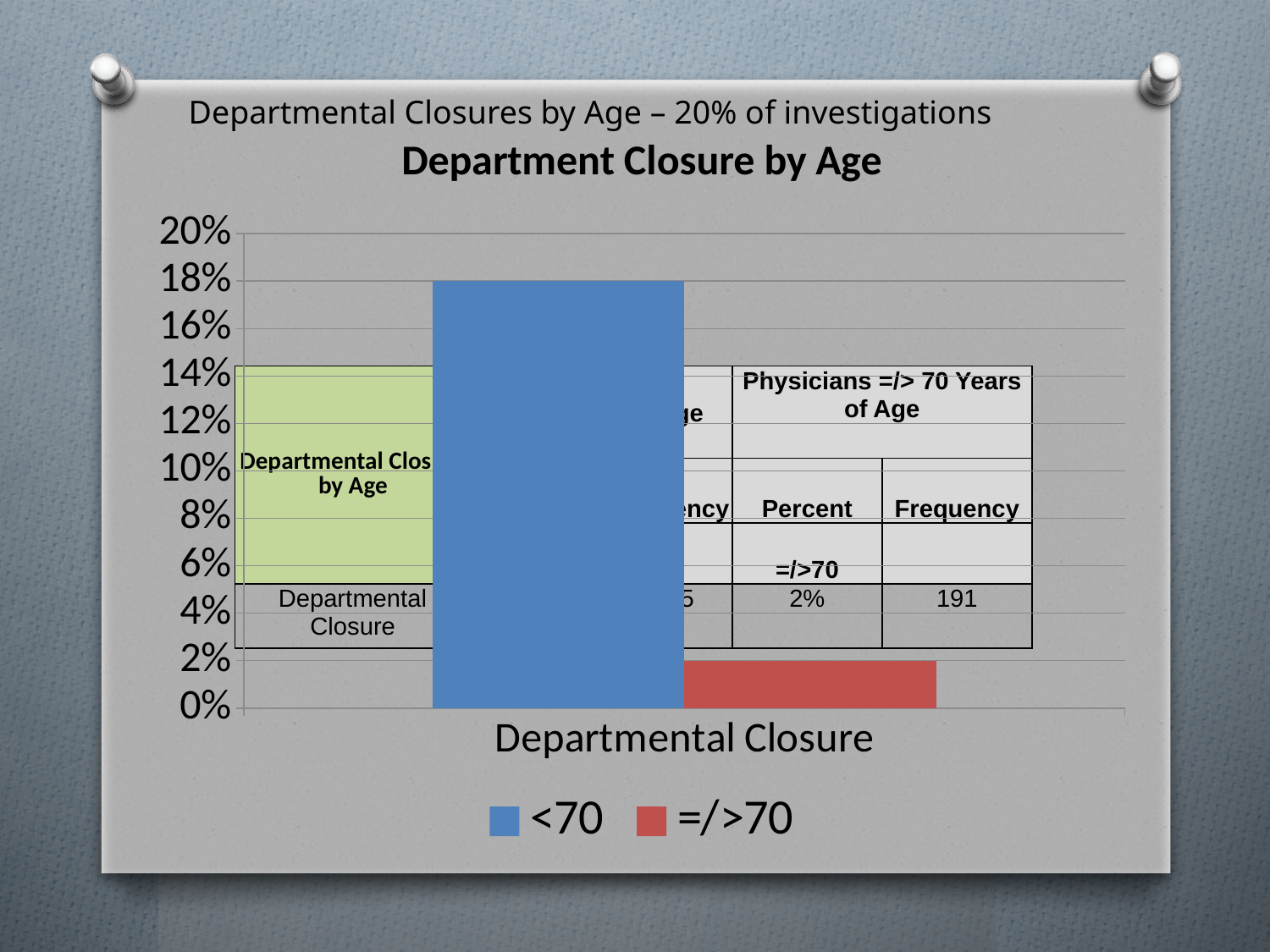
What kind of chart is shown on the slide? bar chart What are the two series named in the legend? <70 and =/>70 What is the value of the =/>70 bar for Departmental Closure? 2% Which series has the lowest value for Departmental Closure? =/>70 What is the title of the chart? Department Closure by Age What is the difference between the <70 value and the =/>70 value for Departmental Closure? 16% Which series has the highest value for Departmental Closure? <70 Is the value for the <70 bar greater or less than 10%? greater What is the value of the <70 bar for Departmental Closure? 18% How many series does the legend list? 2 How many categories are shown on the x axis? 1 Which is larger for Departmental Closure, the <70 bar or the =/>70 bar? <70